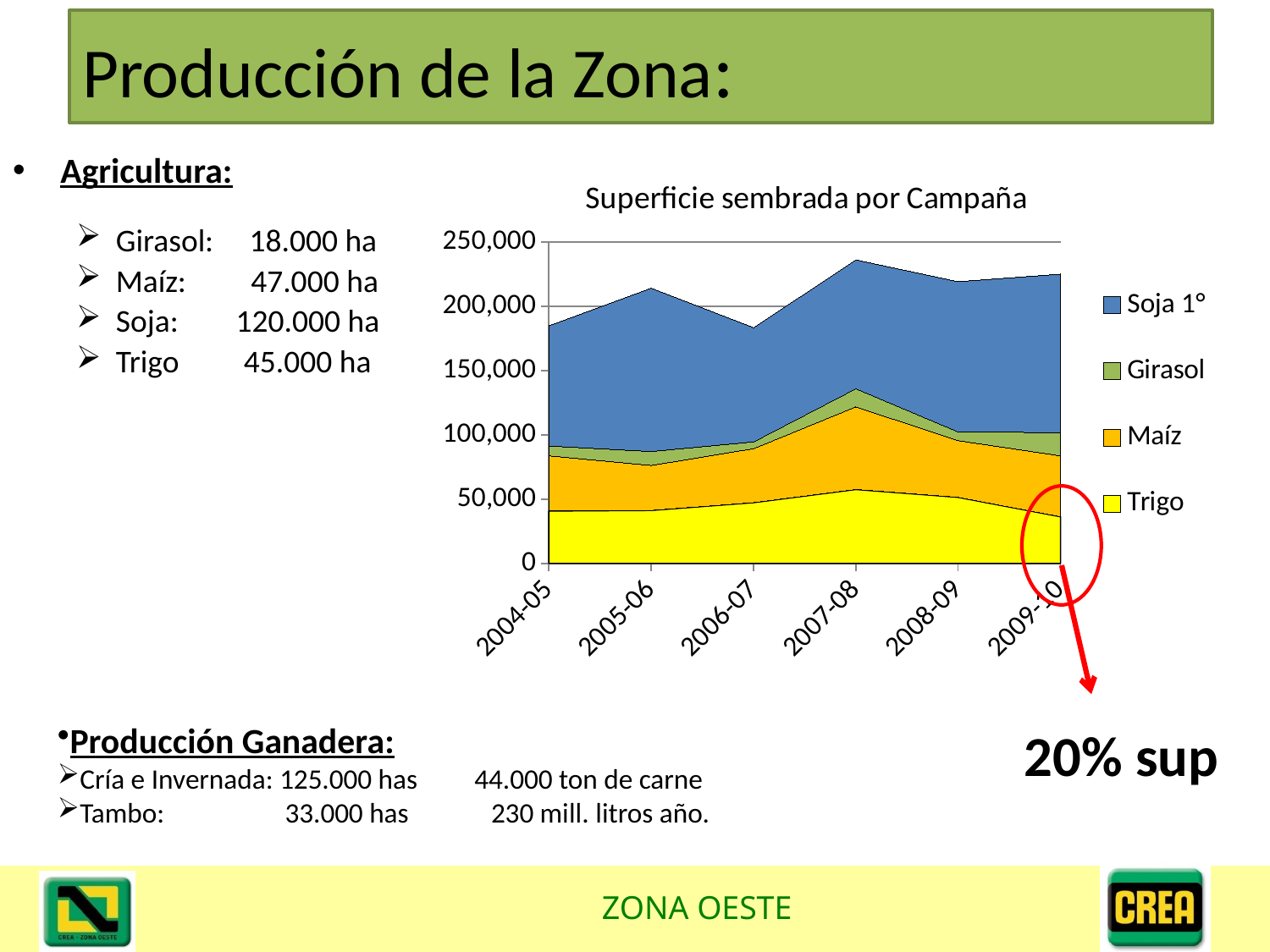
How many series does the chart legend list? 4 Which series is shown in yellow in the chart? Trigo In which campaign is the Trigo area lowest? 2009-10 How many campaigns (x-axis categories) are shown in the chart? 6 Is the Trigo area in 2009-10 greater or less than 50,000? less Is the total sown area in 2006-07 greater or less than 200,000? less What kind of chart is shown on the slide? stacked area chart What is the title of the chart? Superficie sembrada por Campaña In which campaign is the Trigo area highest? 2007-08 Is the total sown area in 2007-08 greater or less than 200,000? greater In which campaign is the total sown area highest? 2007-08 Does the Trigo area rise or fall from 2007-08 to 2009-10? fall